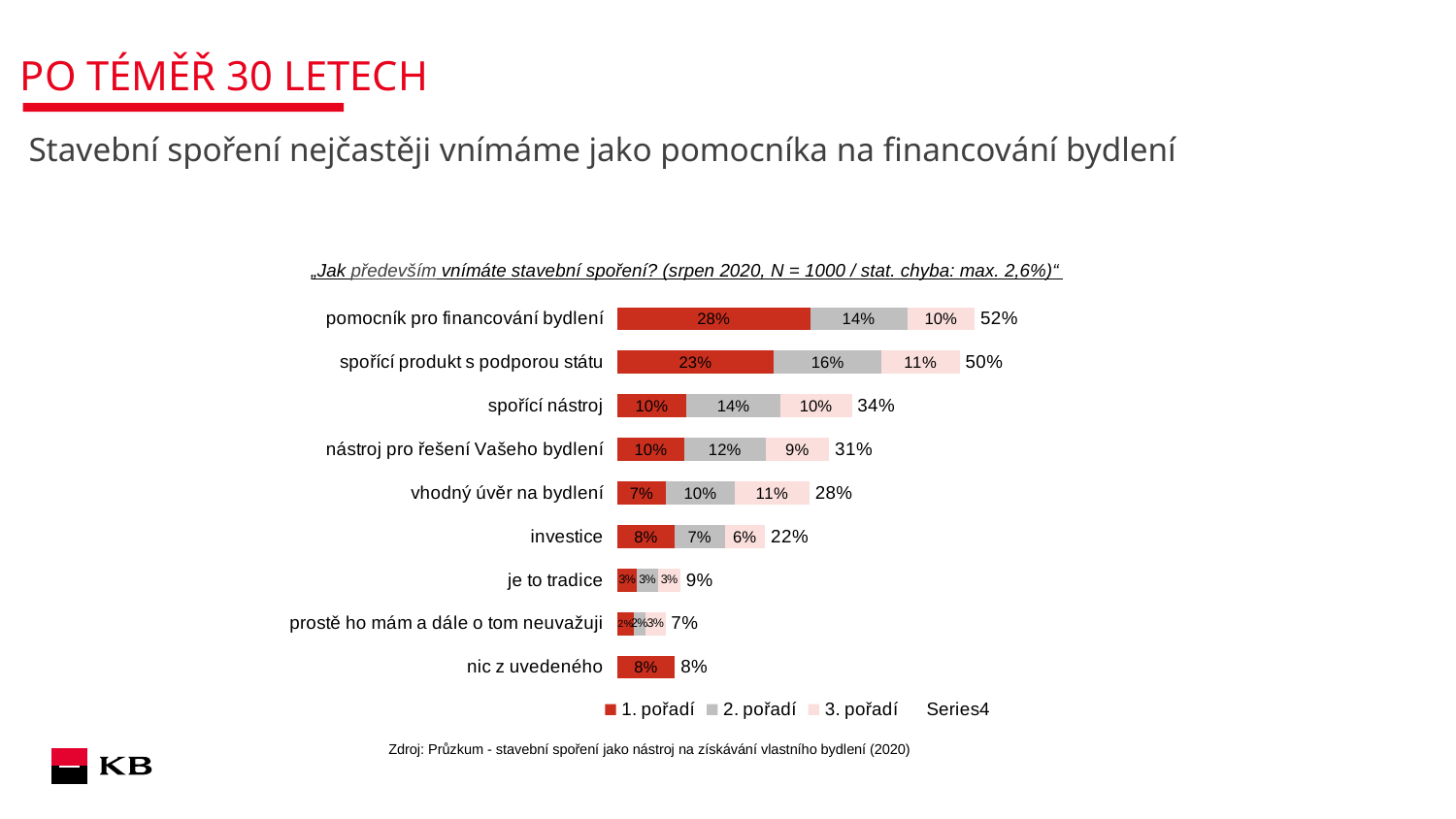
What is the value of "2. pořadí" for "spořící produkt s podporou státu"? 16% Which category has the highest total? pomocník pro financování bydlení How many categories are shown in the chart? 9 What kind of chart is shown on the slide? Stacked bar chart Which has a larger "1. pořadí" value: "spořící produkt s podporou státu" or "spořící nástroj"? spořící produkt s podporou státu What is the value of "3. pořadí" for "vhodný úvěr na bydlení"? 11% What is the total shown for the "nic z uvedeného" bar? 8% What is the total shown for the "investice" bar? 22% What is the difference between the totals for "pomocník pro financování bydlení" and "spořící produkt s podporou státu"? 2% Which category has the lowest total? prostě ho mám a dále o tom neuvažuji How many entries does the legend list? 4 What is the value of "1. pořadí" for "pomocník pro financování bydlení"? 28%